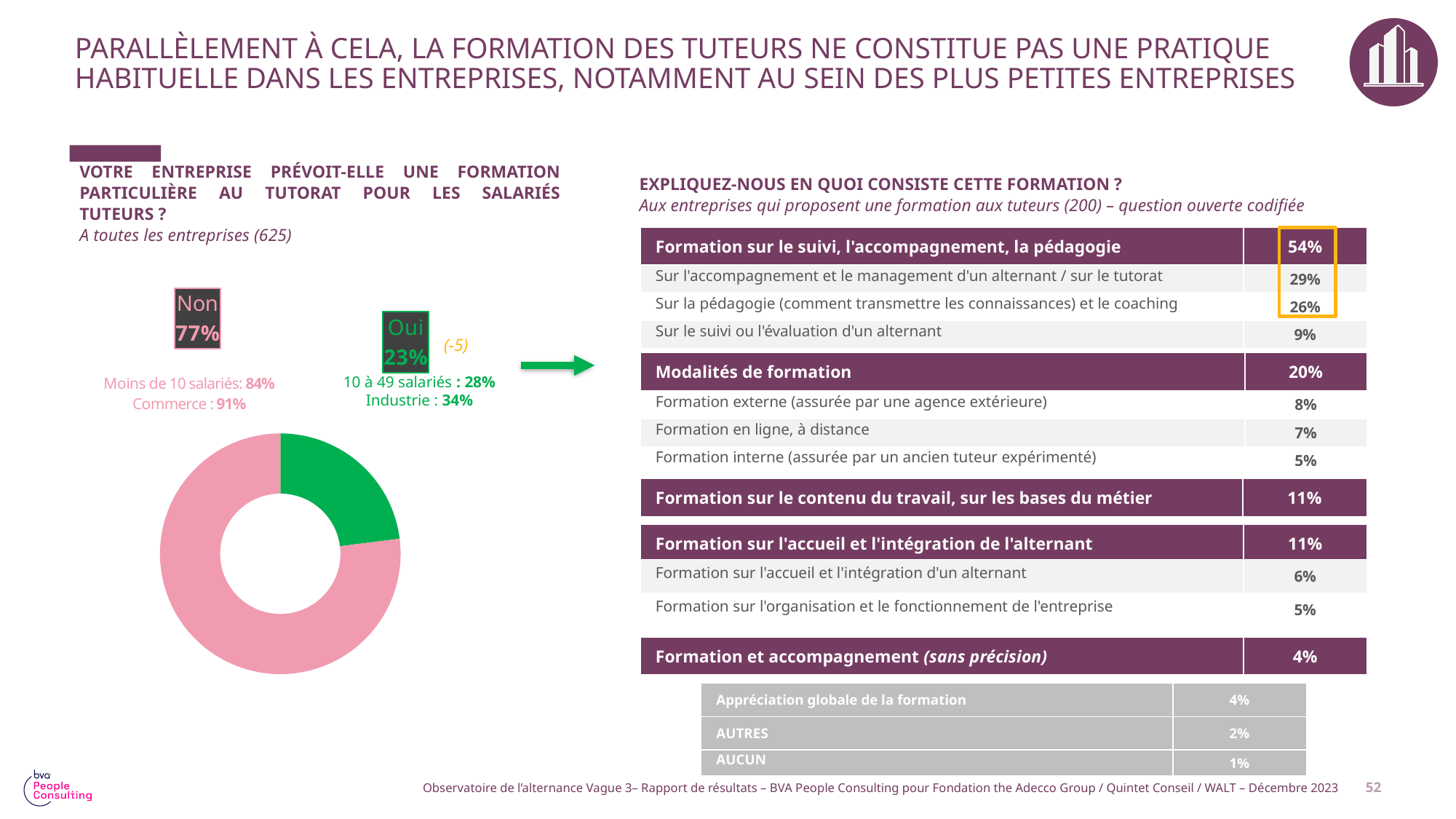
In the donut chart, what is the value for "Oui"? 23% What colour is the "Non" slice in the donut chart? Pink Which category has the largest slice in the donut chart? Non What is the difference between the "Non" and "Oui" values in the donut chart? 54 percentage points Which category has the smallest slice in the donut chart? Oui What colour is the "Oui" slice in the donut chart? Green What kind of chart is shown on the left of the slide? Pie (donut) chart In the donut chart, is the value for "Oui" larger or smaller than the value for "Non"? Smaller How many categories does the donut chart show? 2 What share of the donut chart does the "Oui" slice represent? 23% In the donut chart, what is the value for "Non"? 77%